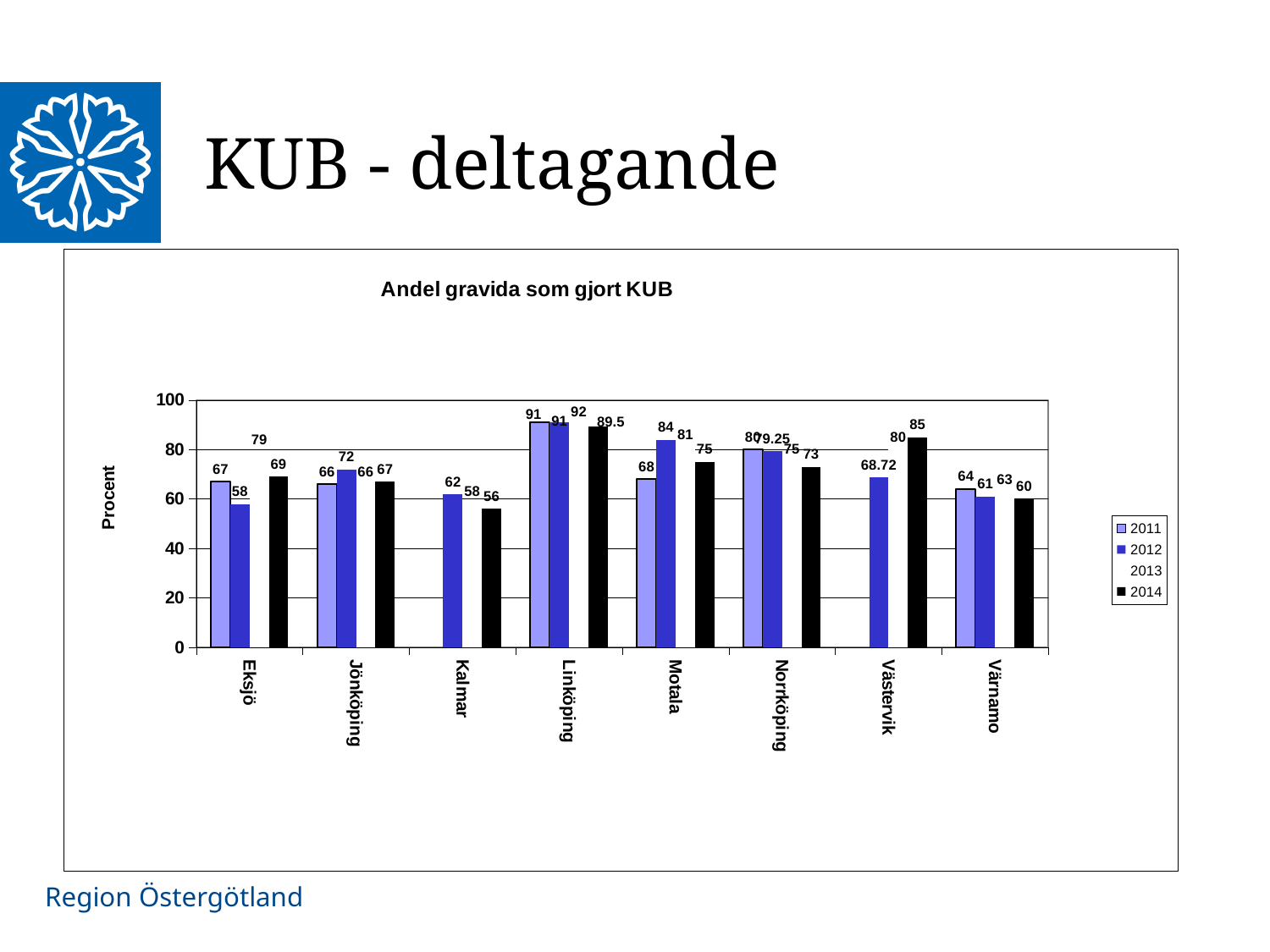
Which is larger, the 2014 value for Motala or the 2014 value for Värnamo? Motala What is the title of the chart? Andel gravida som gjort KUB What is the label of the y axis? Procent What is the 2012 value for Motala? 84 How many categories are shown on the x axis? 8 Which category has the highest 2014 value? Linköping Which category has the lowest 2014 value? Kalmar What is the 2014 value for Västervik? 85 What kind of chart is shown on the slide? bar chart What is the 2014 value for Linköping? 89.5 How many series does the legend list? 4 What is the difference between the 2012 and 2011 values for Eksjö? 9